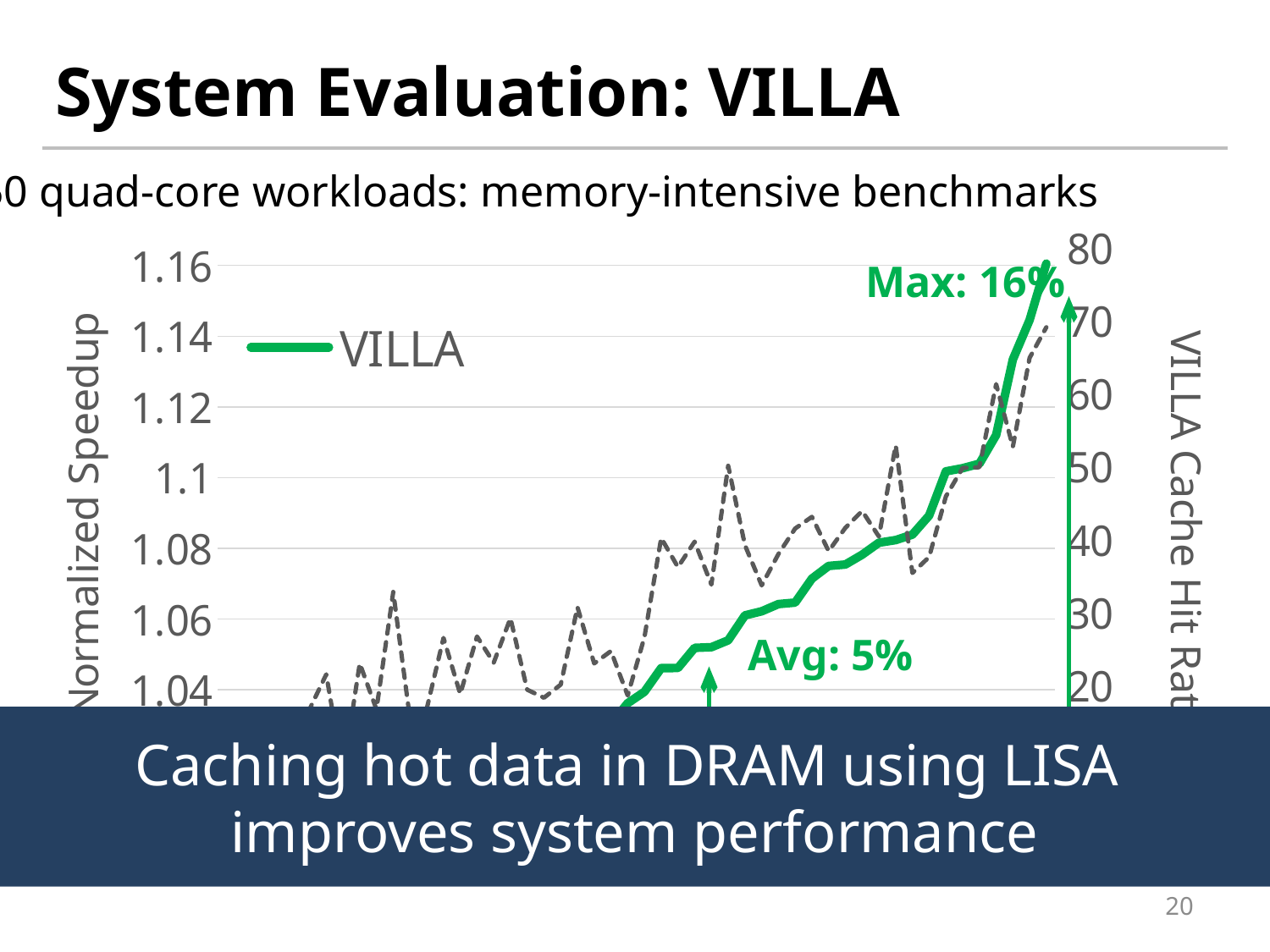
What is the highest tick value shown on the left vertical axis (Normalized Speedup)? 1.16 Does the VILLA normalized speedup line rise or fall from left to right along the x axis? rise How many series does the chart's legend list? 1 What is the label of the left vertical axis of the chart? Normalized Speedup Is the highest point of the VILLA normalized speedup line greater or less than 1.1? greater Which is larger, the maximum speedup improvement or the average speedup improvement annotated on the chart? the maximum (16%) What is the name of the series shown in the chart's legend? VILLA Is the highest point of the VILLA normalized speedup line greater or less than 1.14? greater What average speedup improvement does the annotation on the chart report for VILLA? 5% What kind of chart is shown on the slide? line chart What is the highest tick value shown on the right vertical axis (VILLA Cache Hit Rate)? 80 What maximum speedup improvement does the annotation on the chart report for VILLA? 16%